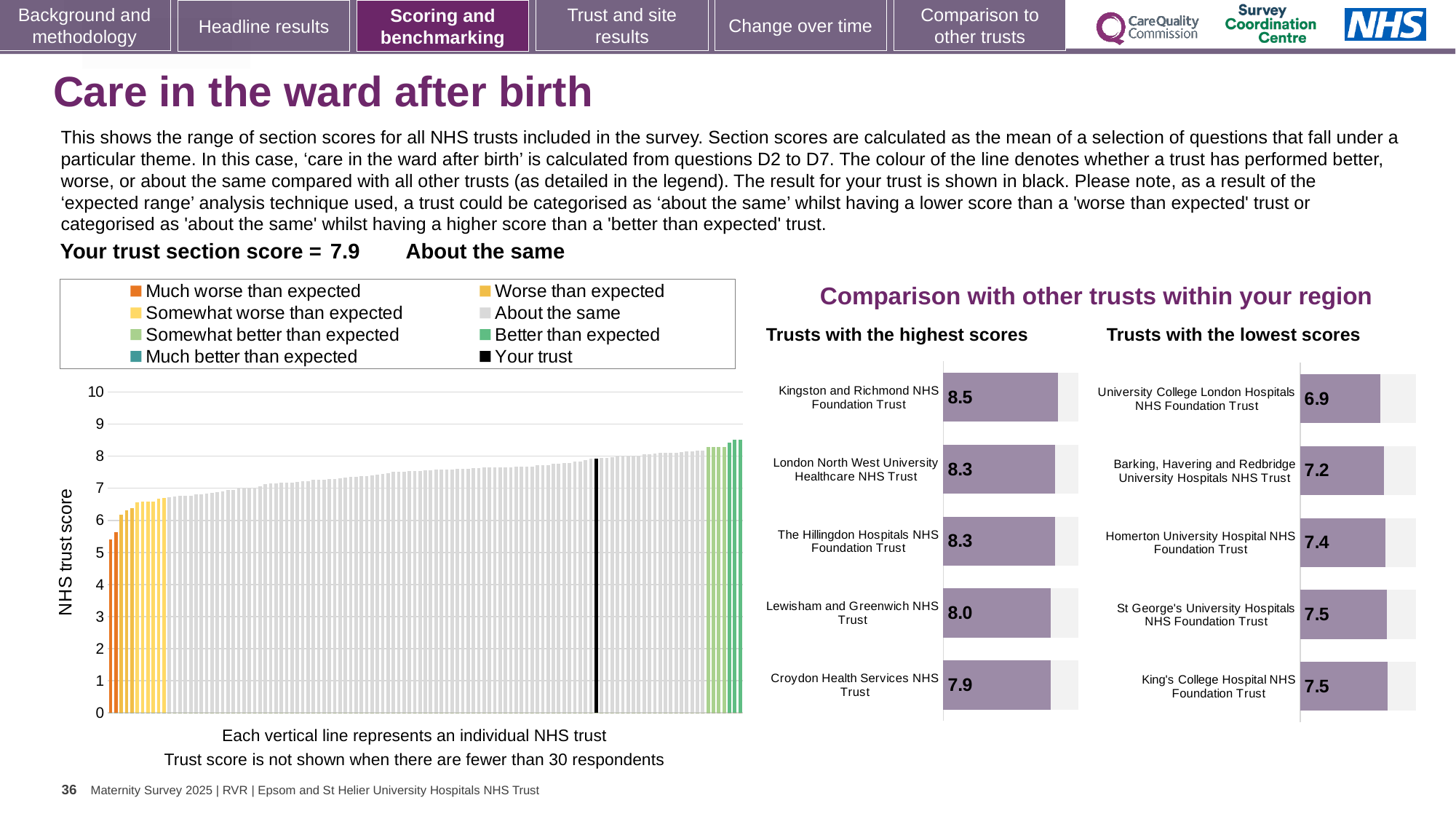
What kind of chart is the main chart on the left showing NHS trust scores? Bar chart In the main 'NHS trust score' chart, is the value of the leftmost bar greater or less than 6? less How many trusts are shown in the 'Trusts with the lowest scores' chart? 5 In the 'Trusts with the lowest scores' chart, which trust has the lowest score? University College London Hospitals NHS Foundation Trust In the 'Trusts with the highest scores' chart, what is the score for Kingston and Richmond NHS Foundation Trust? 8.5 In the 'Trusts with the highest scores' chart, which trust has the highest score? Kingston and Richmond NHS Foundation Trust In the 'Trusts with the lowest scores' chart, which has the larger score: Barking, Havering and Redbridge University Hospitals NHS Trust or King's College Hospital NHS Foundation Trust? King's College Hospital NHS Foundation Trust What is the title of the chart section on the right of the slide? Comparison with other trusts within your region In the main 'NHS trust score' chart, do the bar values rise or fall from left to right? Rise How many entries does the legend of the main 'NHS trust score' chart list? 8 In the 'Trusts with the highest scores' chart, what is the difference between the scores of Kingston and Richmond NHS Foundation Trust and Croydon Health Services NHS Trust? 0.6 In the 'Trusts with the lowest scores' chart, what is the score for Homerton University Hospital NHS Foundation Trust? 7.4